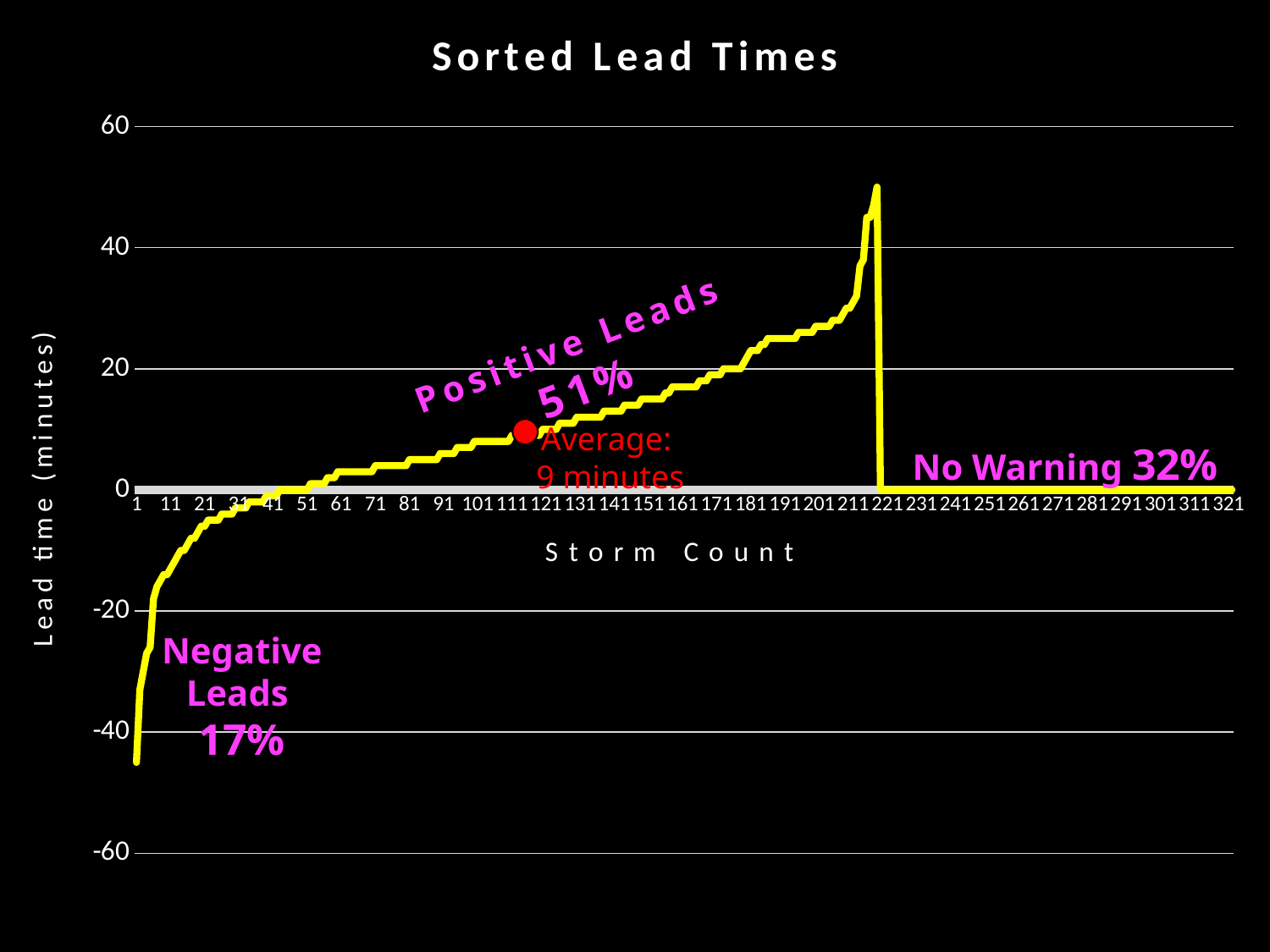
What is the difference in percentage points between positive leads (51%) and negative leads (17%)? 34 What percentage of storms had no warning according to the chart annotation? 32% What kind of chart is shown on the slide? line chart What average lead time is marked on the chart? 9 minutes What percentage of storms had positive leads according to the chart annotation? 51% Which group is larger, positive leads or negative leads? Positive Leads Do the lead times rise or fall along the x axis from storm count 1 to about storm count 221? rise What is the title of the chart? Sorted Lead Times Is the highest lead time on the chart, near storm count 221, greater or less than 40? greater Is the lead time for storm count 1 greater or less than -40? less What is the label of the y axis? Lead time (minutes) What percentage of storms had negative leads according to the chart annotation? 17%